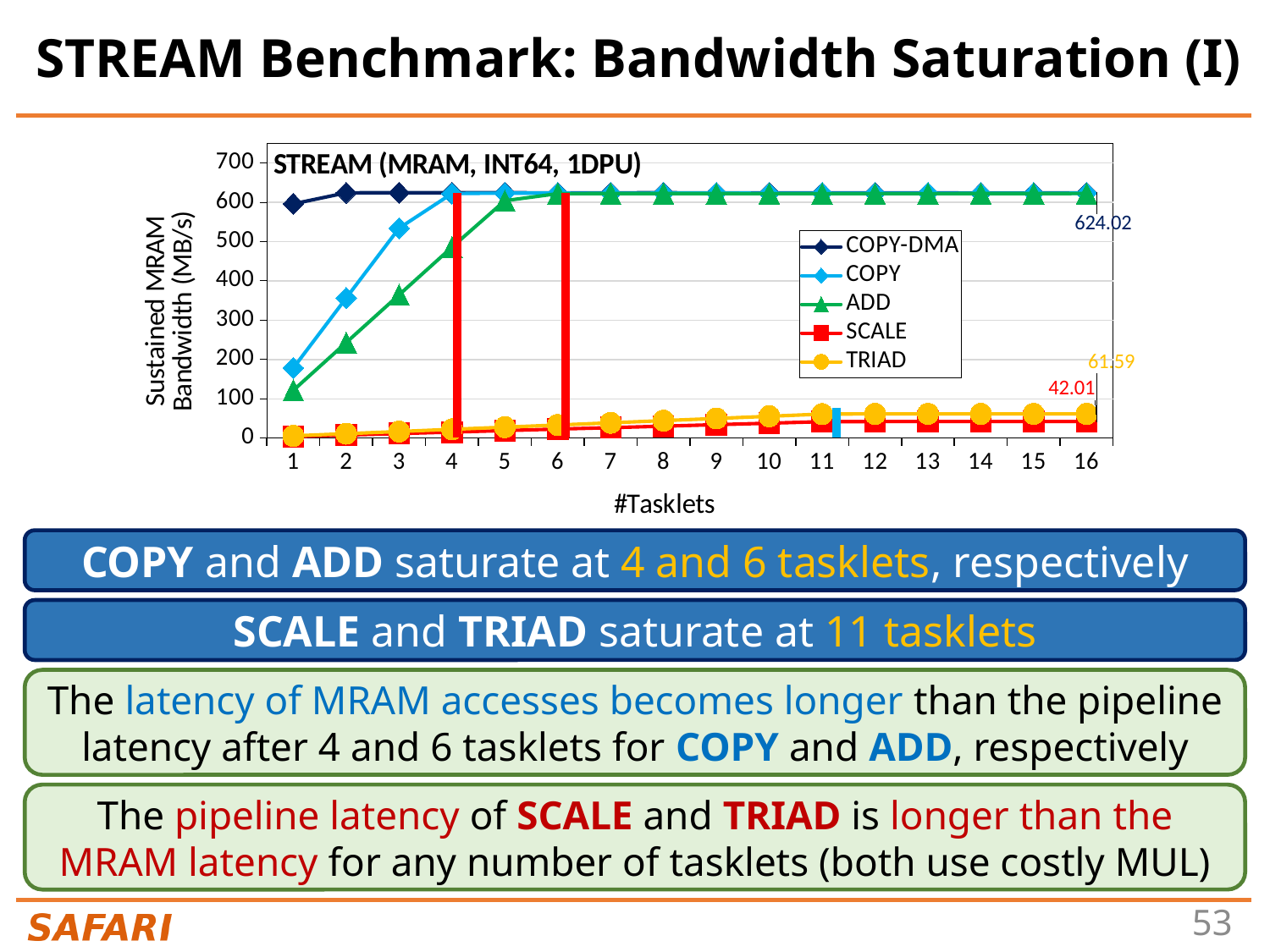
How many series does the chart legend list? 5 How many tasklet values are plotted along the x axis? 16 What type of chart is shown on the slide? line chart What is the labeled value of SCALE at 16 tasklets? 42.01 At 2 tasklets, which series has the higher bandwidth, COPY or ADD? COPY Is the value for COPY at 1 tasklet greater or less than 100? greater Which series has the lowest bandwidth at 16 tasklets? SCALE What is the labeled value of TRIAD at 16 tasklets? 61.59 What is the title shown inside the chart area? STREAM (MRAM, INT64, 1DPU) What is the difference between the labeled TRIAD and SCALE values at 16 tasklets? 19.58 What is the labeled value of COPY-DMA at 16 tasklets? 624.02